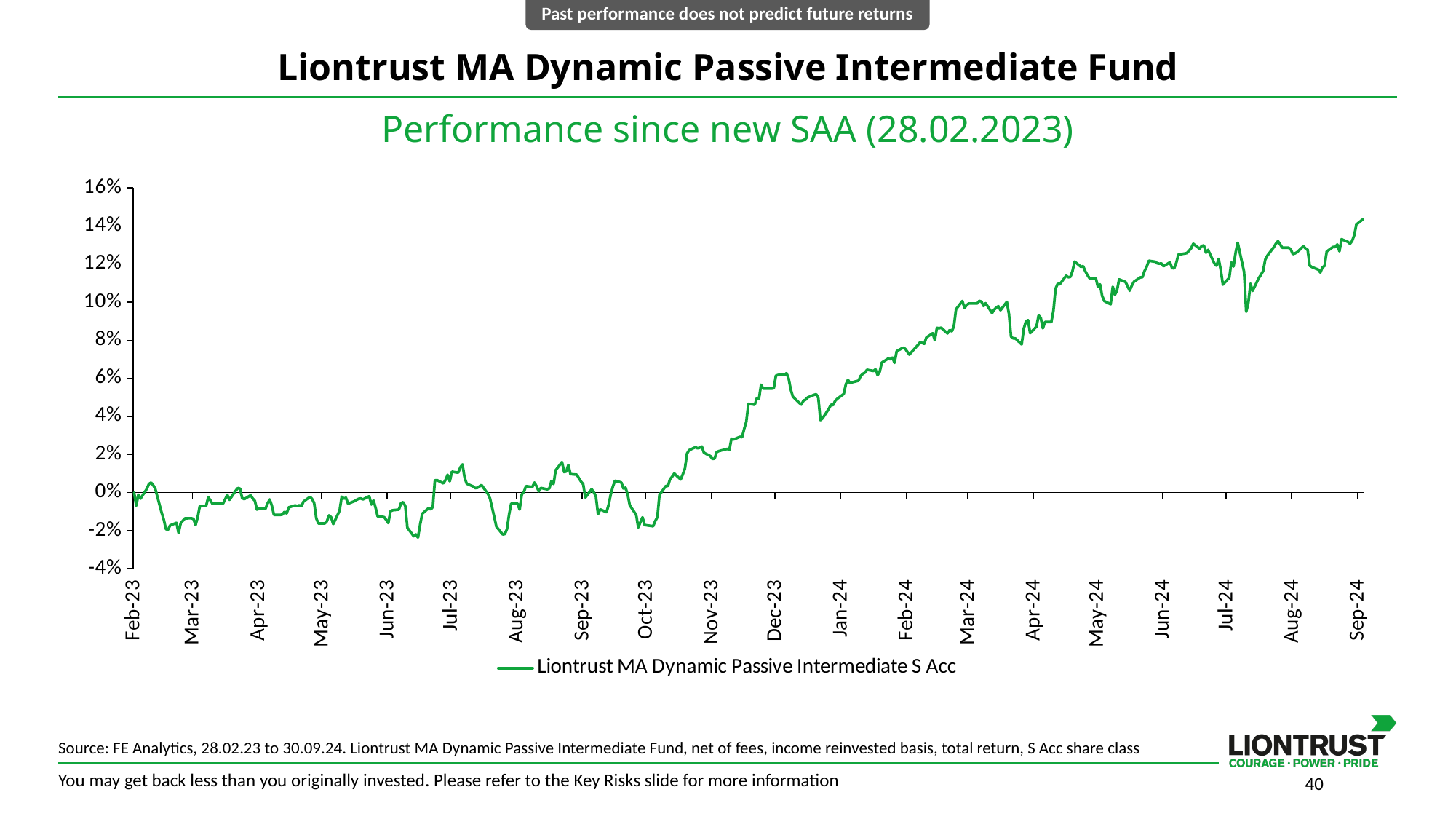
Is the value at Apr-24 greater or less than 10%? less What is the name of the series shown in the legend? Liontrust MA Dynamic Passive Intermediate S Acc Is the value at Dec-23 greater or less than 4%? greater Is the value at Sep-24 greater or less than 12%? greater What kind of chart is shown on the slide? line chart How many month labels are shown on the x axis? 20 How many series does the legend list? 1 Overall, does the line rise or fall from Feb-23 to Sep-24? rise What is the title of the chart? Performance since new SAA (28.02.2023) What is the highest value shown on the y axis? 16%